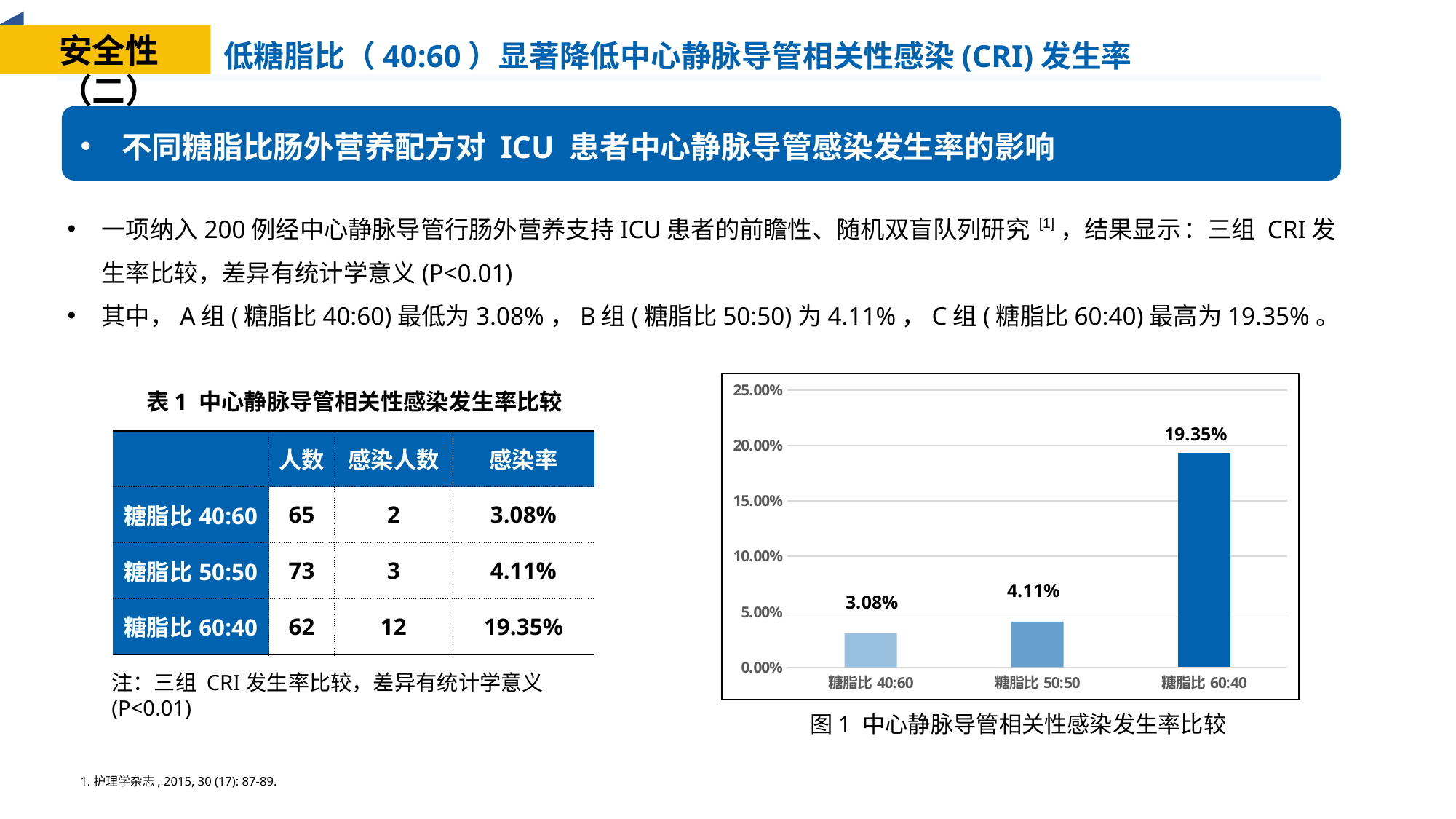
What is the value for 糖脂比 50:50 in the chart? 4.11% Which category has the lowest value in the chart? 糖脂比 40:60 What is the difference between the values for 糖脂比 50:50 and 糖脂比 40:60? 1.03% Which category has the highest value in the chart? 糖脂比 60:40 Which is larger, the value for 糖脂比 50:50 or the value for 糖脂比 60:40? 糖脂比 60:40 What is the value for 糖脂比 60:40 in the chart? 19.35% How many categories are shown on the x axis of the chart? 3 Is the value for 糖脂比 60:40 greater or less than 15.00%? greater What kind of chart is shown on the slide? bar chart What is the value for 糖脂比 40:60 in the chart? 3.08% What is the difference between the values for 糖脂比 60:40 and 糖脂比 40:60? 16.27% What is the caption of the chart shown on the slide? 图 1 中心静脉导管相关性感染发生率比较